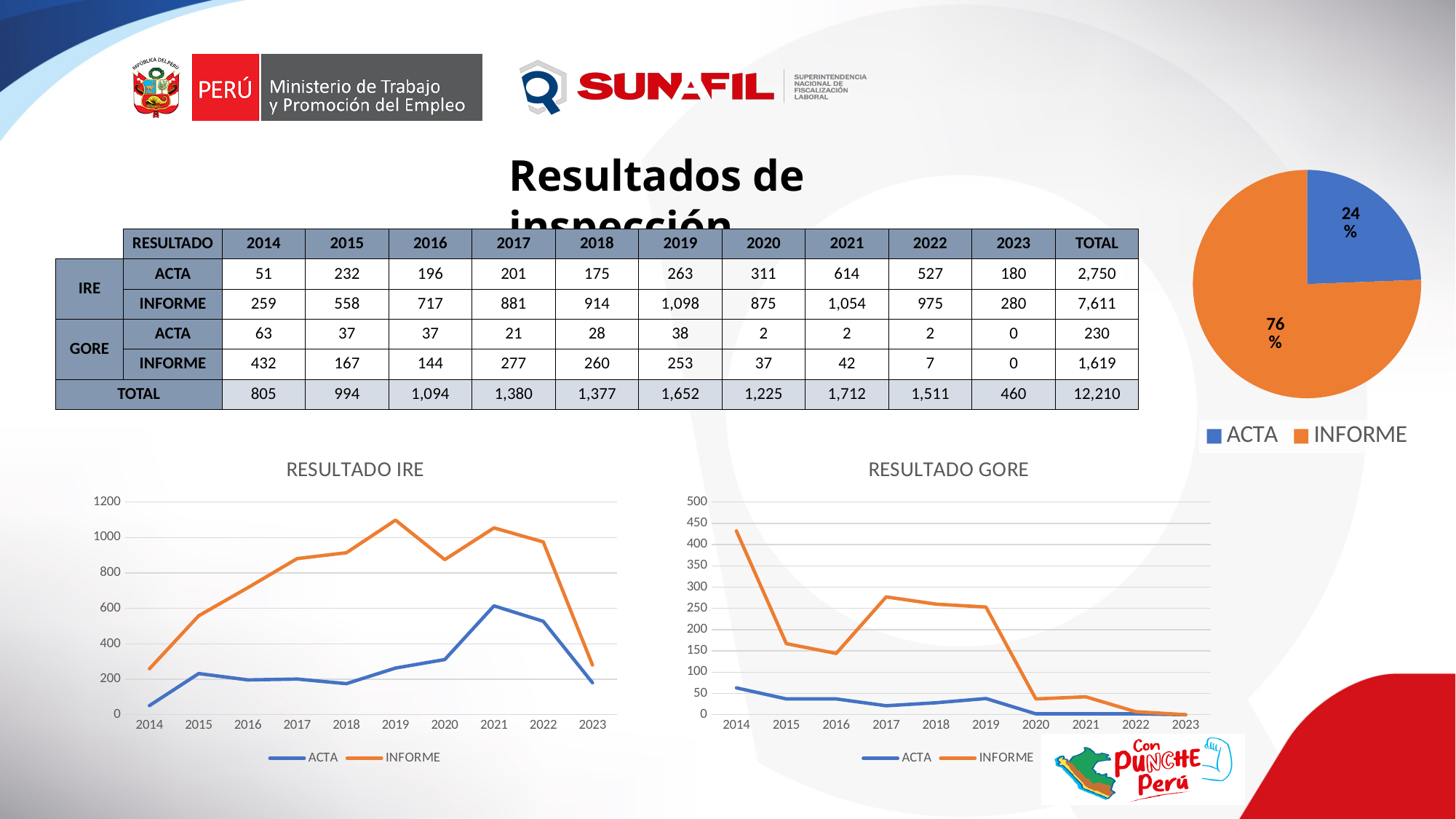
In the RESULTADO GORE chart, does the INFORME line rise or fall from 2019 to 2020? fall In the pie chart at the top right, what share does ACTA have? 24% In the RESULTADO IRE chart, is the INFORME value for 2019 greater or less than 1000? greater In the RESULTADO IRE chart, what is the difference between INFORME and ACTA in 2019? 835 In the RESULTADO GORE chart, is the INFORME value for 2014 greater or less than 400? greater In the RESULTADO IRE chart, what is the ACTA value for 2021? 614 How many years are shown on the x axis of the RESULTADO IRE chart? 10 In the RESULTADO GORE chart, in which year is the INFORME line highest? 2014 What kind of chart is RESULTADO IRE? line chart How many series does the legend of the pie chart at the top right list? 2 In the RESULTADO IRE chart, in which year does the ACTA line reach its highest value? 2021 In the pie chart at the top right, which slice is larger, ACTA or INFORME? INFORME